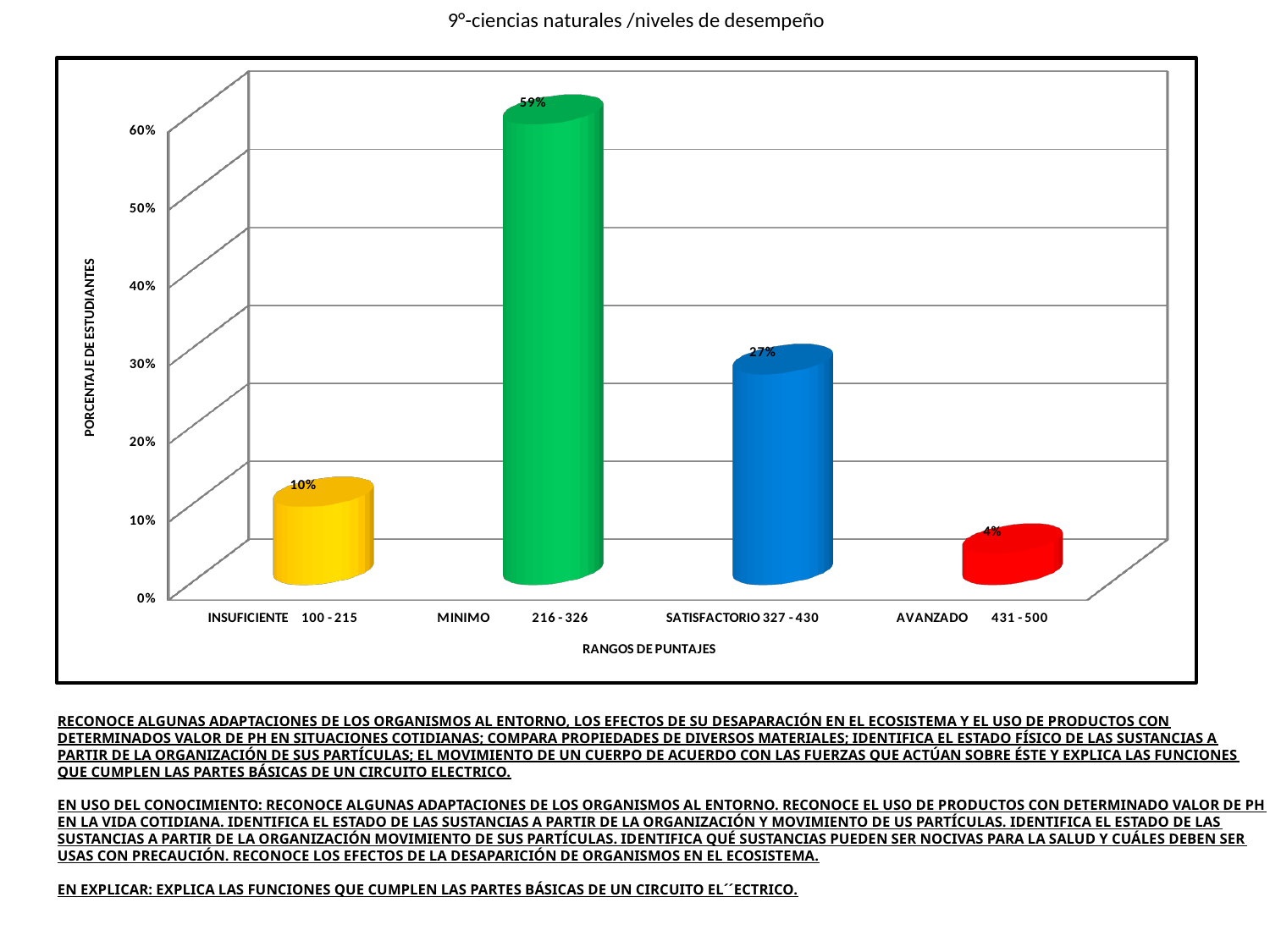
Which category has a larger percentage, INSUFICIENTE or AVANZADO? INSUFICIENTE What is the label of the vertical axis? PORCENTAJE DE ESTUDIANTES Which category has the lowest percentage of students? AVANZADO Which category has the highest percentage of students? MINIMO What percentage of students is shown for the MINIMO (216 - 326) category? 59% What is the title of the chart? 9°-ciencias naturales /niveles de desempeño What percentage of students is shown for the SATISFACTORIO (327 - 430) category? 27% What is the difference in percentage points between the MINIMO and SATISFACTORIO categories? 32 What kind of chart is shown on the slide? Bar chart What percentage of students is shown for the AVANZADO (431 - 500) category? 4% How many categories are shown on the x axis of the chart? 4 What percentage of students is shown for the INSUFICIENTE (100 - 215) category? 10%